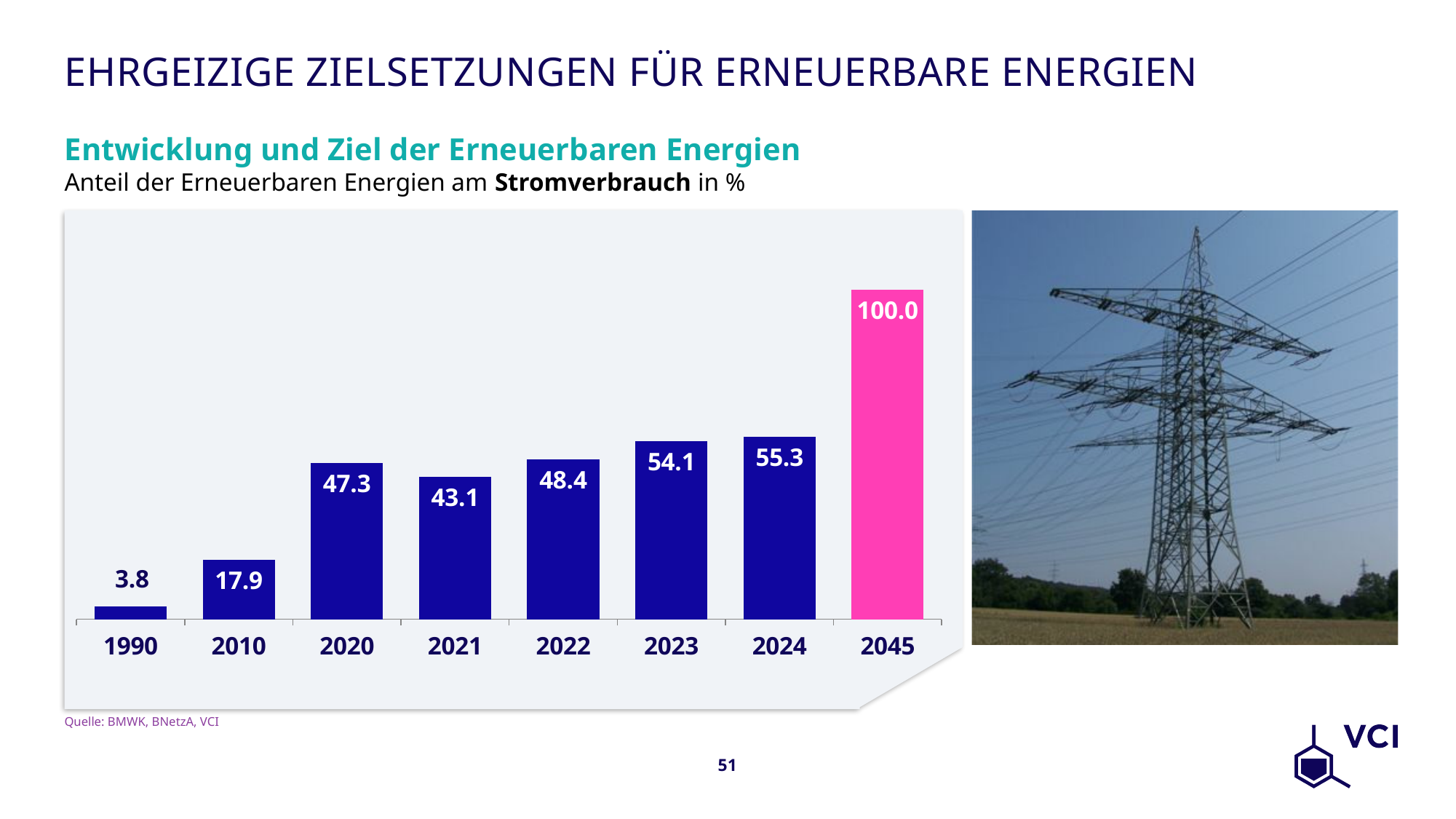
What value is shown for 2024? 55.3 What value is shown for 1990? 3.8 What is the share of renewable energies in electricity consumption shown for 2020? 47.3 What type of chart is shown on the slide? Bar chart What is the difference between the 2045 target and the 2024 value? 44.7 Which bar is shown in a different colour (pink) from the others? 2045 What is the difference between the values for 2024 and 2023? 1.2 How many years (bars) are shown in the chart? 8 What is the target value shown for 2045? 100.0 Which year has the lowest value in the chart? 1990 Which is larger, the value for 2020 or the value for 2021? 2020 Which year has the highest value in the chart? 2045